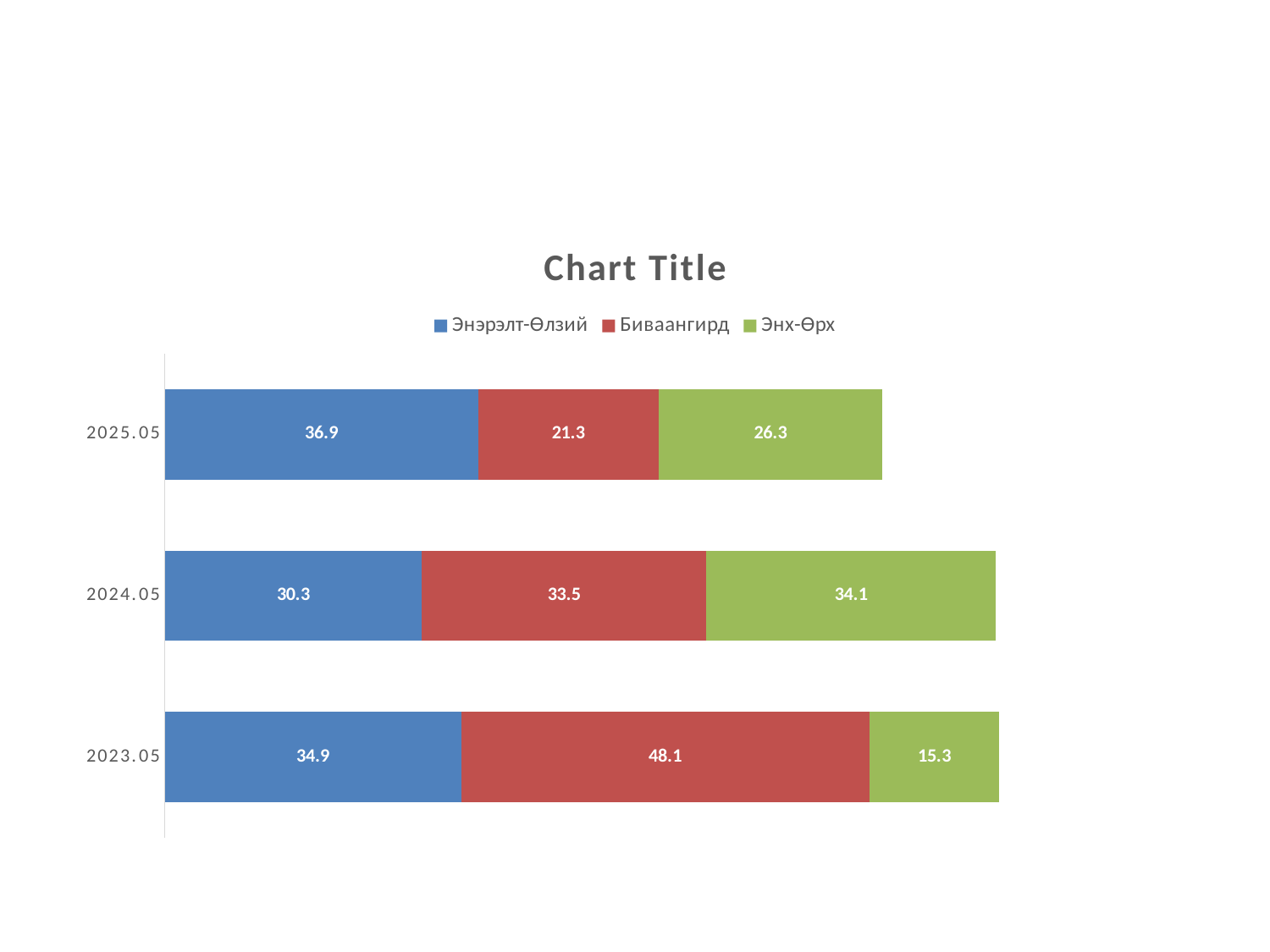
What is the value for Энэрэлт-Өлзий in 2025.05? 36.9 What is the value for Биваангирд in 2023.05? 48.1 What is the title of the chart? Chart Title Which is larger in 2025.05: the value for Энэрэлт-Өлзий or the value for Энх-Өрх? Энэрэлт-Өлзий What is the value for Энх-Өрх in 2024.05? 34.1 What kind of chart is shown? Stacked bar chart How many years are shown on the chart? 3 In which year is the value for Энх-Өрх lowest? 2023.05 What is the total of the stacked bar for 2025.05? 84.5 What is the difference between the Биваангирд values for 2023.05 and 2025.05? 26.8 In which year is the value for Биваангирд highest? 2023.05 How many series does the legend list? 3